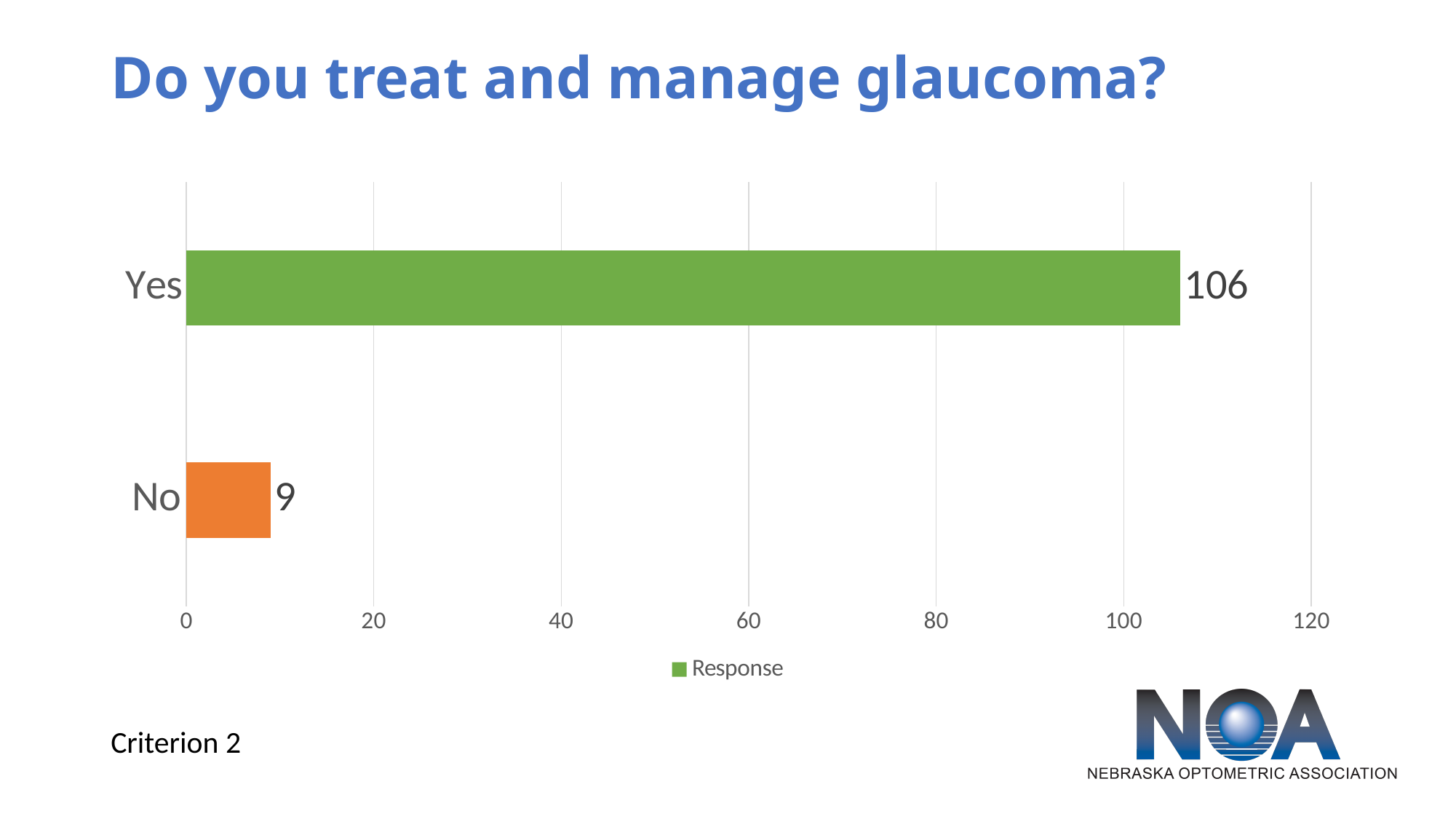
What is the value for Yes? 106 Is the value for No greater or less than 20? less Is the value for Yes greater or less than 100? greater How many series does the legend list? 1 Which is larger, the value for Yes or the value for No? Yes What is the difference between the values for Yes and No? 97 What is the title of the chart? Do you treat and manage glaucoma? What is the value for No? 9 What kind of chart is shown on the slide? bar chart Which category has the highest value? Yes How many categories are shown in the chart? 2 Which category has the lowest value? No